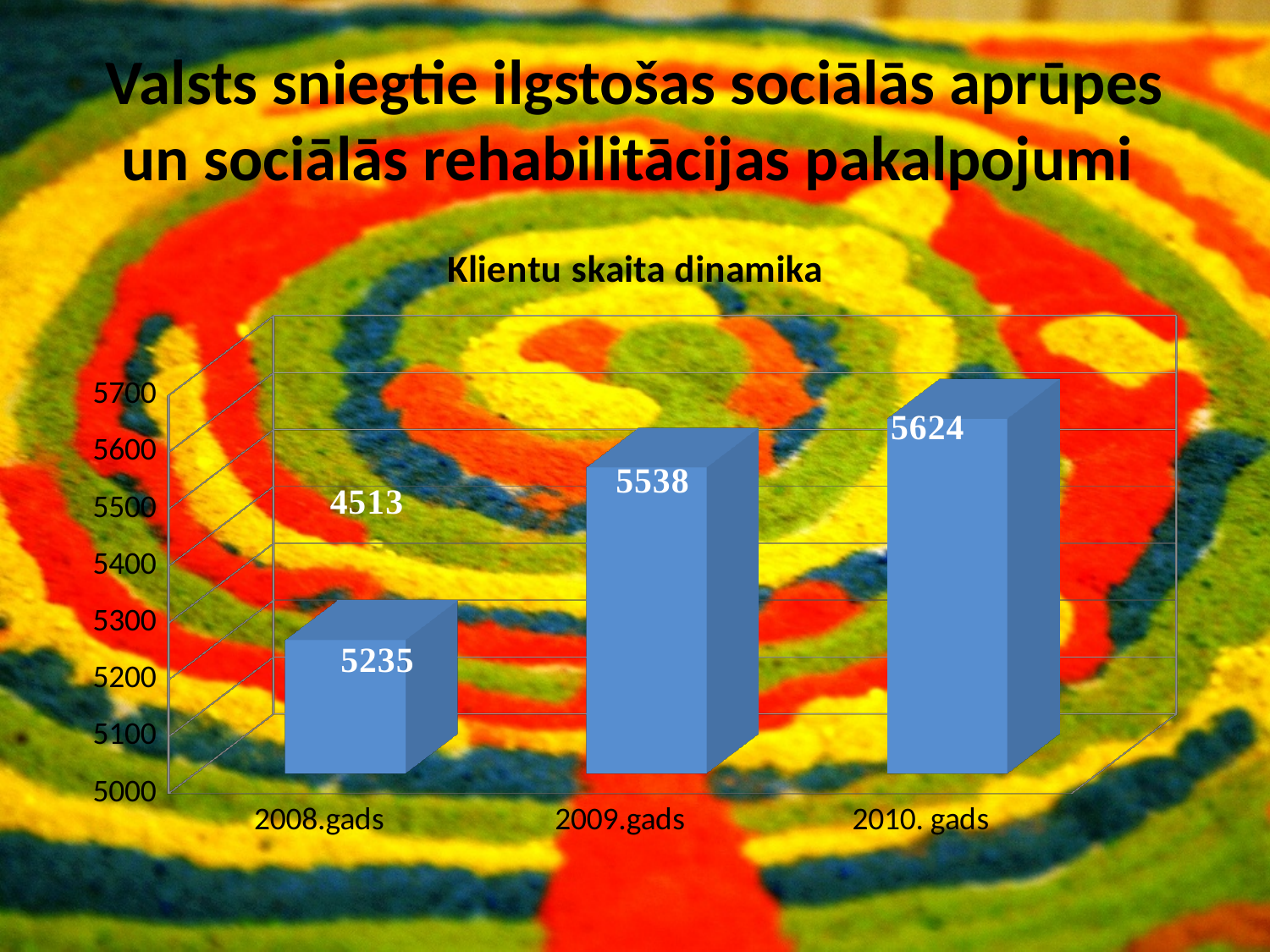
What is the value for 2008.gads in the Klientu skaita dinamika chart? 5235 Do the values rise or fall from 2008.gads to 2010. gads? rise What is the value for 2009.gads in the Klientu skaita dinamika chart? 5538 Which year has the lowest value in the chart? 2008.gads What is the difference between the values for 2009.gads and 2008.gads? 303 Which year has the highest value in the chart? 2010. gads Which is larger, the value for 2009.gads or the value for 2010. gads? 2010. gads What is the value for 2010. gads in the Klientu skaita dinamika chart? 5624 Is the value for 2008.gads greater or less than 5300? less What kind of chart is shown on the slide? bar chart How many years are shown on the x axis of the chart? 3 What is the difference between the values for 2010. gads and 2008.gads? 389